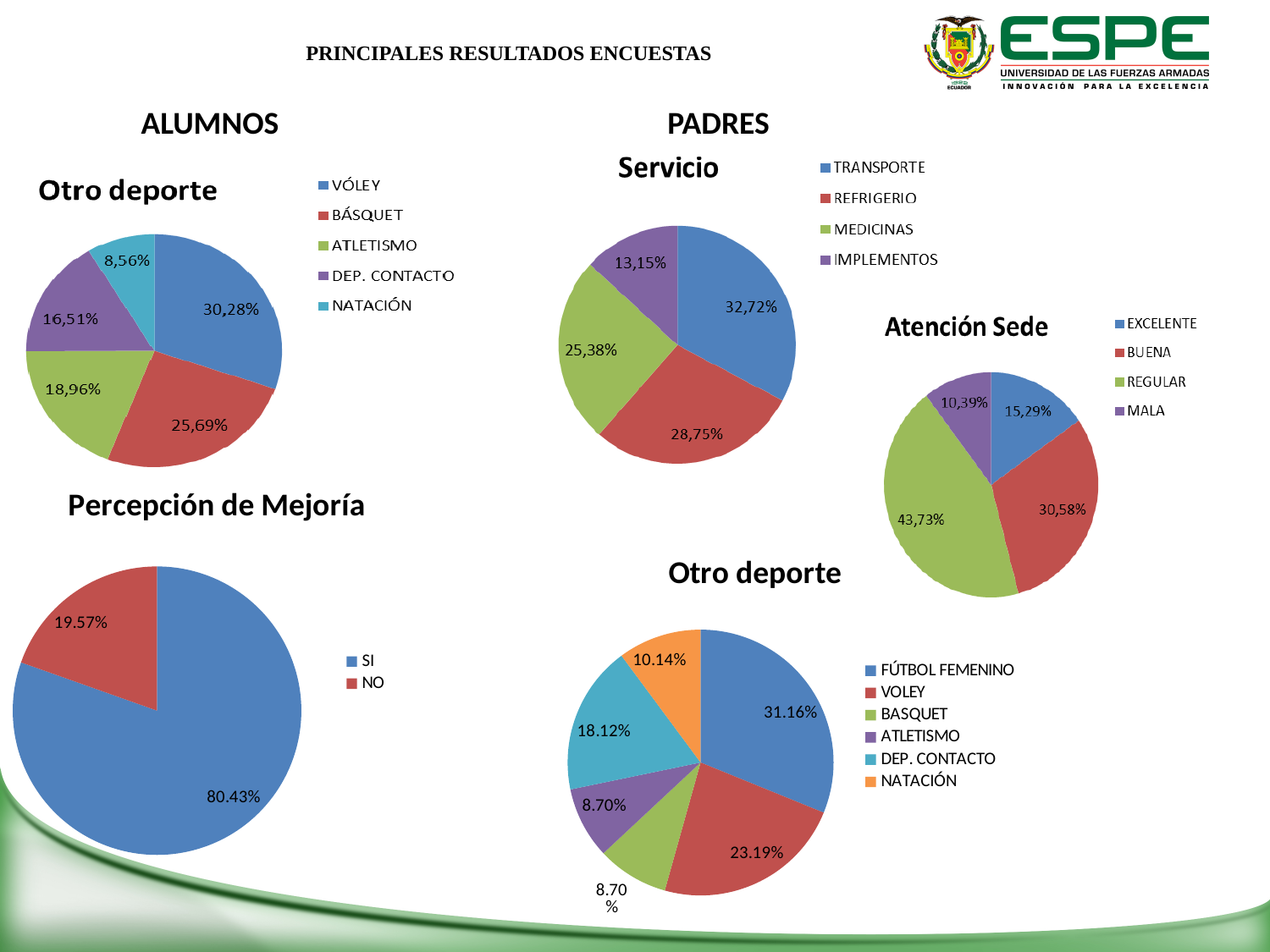
In the ALUMNOS 'Otro deporte' pie chart, what percentage is shown for VÓLEY? 30,28% What type of chart is the 'Percepción de Mejoría' chart? Pie chart In the 'Percepción de Mejoría' pie chart, what is the difference between the SI and NO percentages? 60.86% In the 'Percepción de Mejoría' pie chart, what percentage is shown for SI? 80.43% In the 'Atención Sede' pie chart, which is larger, BUENA or EXCELENTE? BUENA In the PADRES 'Servicio' pie chart, which category has the largest slice? TRANSPORTE In the ALUMNOS 'Otro deporte' pie chart, how many categories does the legend list? 5 In the PADRES 'Otro deporte' pie chart, what percentage is shown for DEP. CONTACTO? 18.12% In the 'Atención Sede' pie chart, what percentage is shown for REGULAR? 43,73% In the PADRES 'Servicio' pie chart, what percentage is shown for MEDICINAS? 25,38% In the ALUMNOS 'Otro deporte' pie chart, which category has the smallest slice? NATACIÓN In the PADRES 'Otro deporte' pie chart, how many categories does the legend list? 6